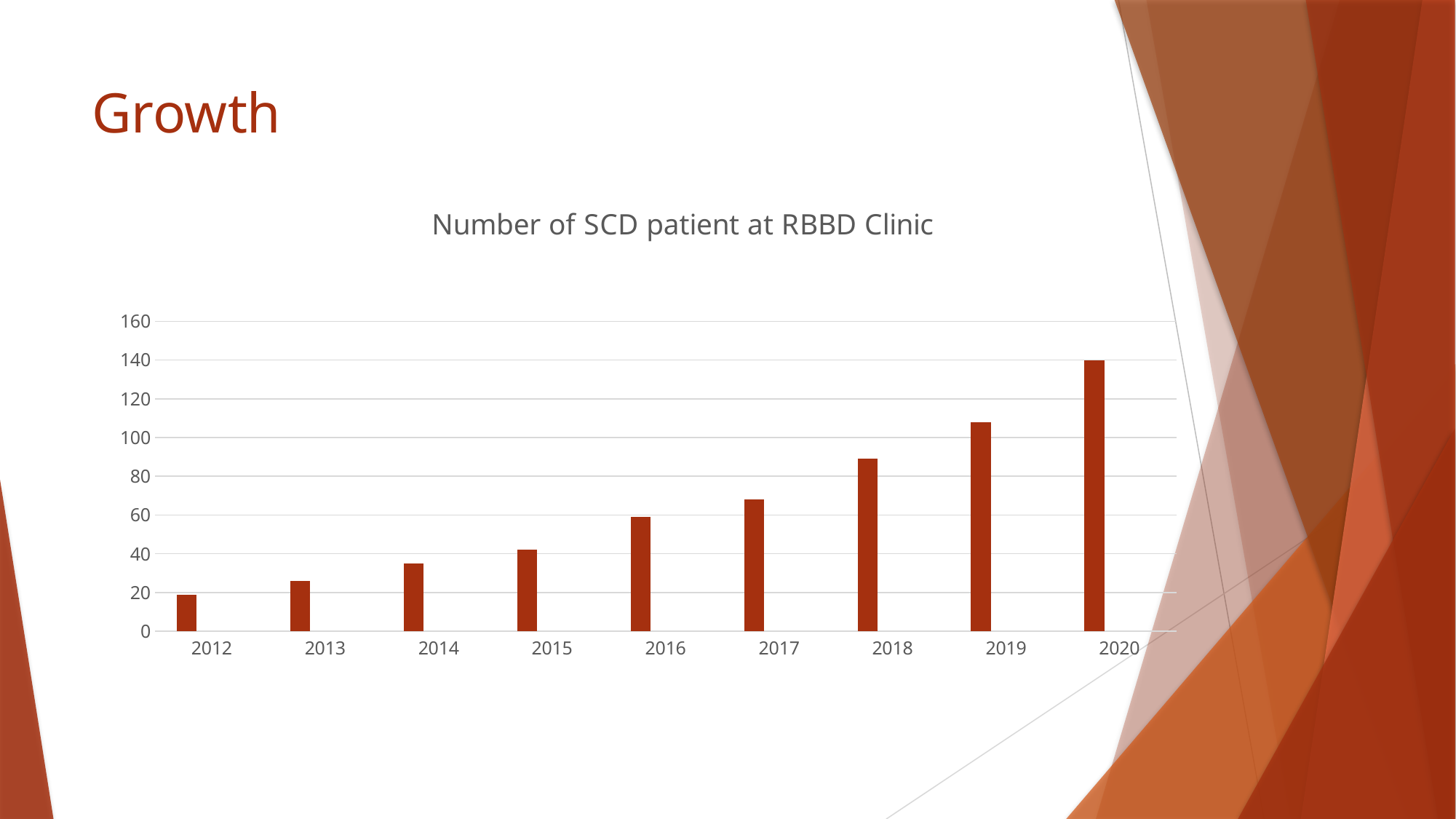
Do the values rise or fall from 2012 to 2020? rise Is the value for 2014 greater or less than 40? less Is the value for 2019 greater or less than 100? greater Is the value for 2018 greater or less than 100? less Which year has more SCD patients, 2016 or 2018? 2018 Which year has the highest number of SCD patients? 2020 How many years are shown on the x axis of the chart? 9 What kind of chart is shown on the slide? bar chart Which year has the lowest number of SCD patients? 2012 What is the title of the chart? Number of SCD patient at RBBD Clinic